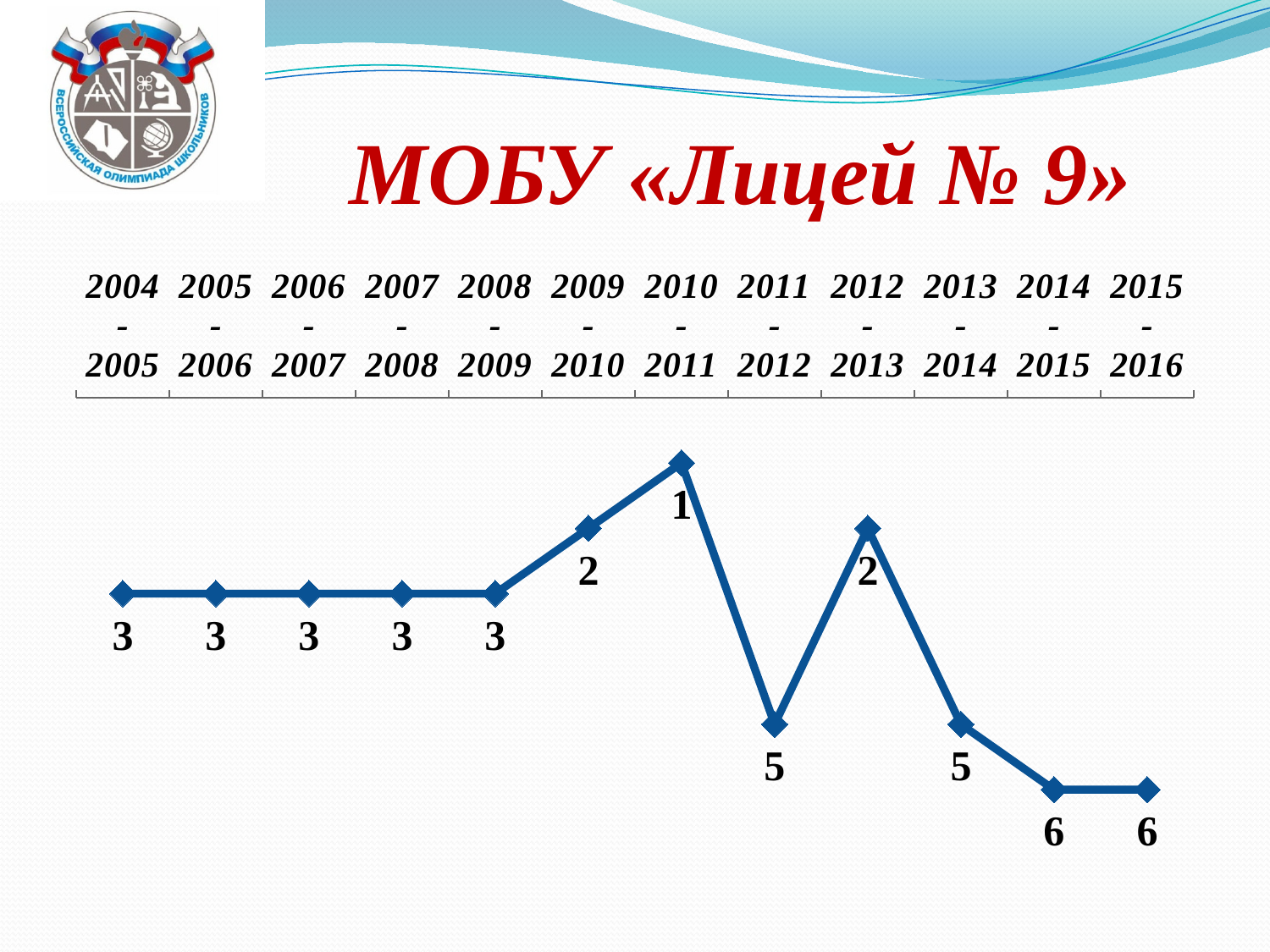
What is the title of the slide above the chart? МОБУ «Лицей № 9» What is the value for 2009-2010? 2 What kind of chart is shown on the slide? line chart Which period has the lowest value? 2010-2011 Do the values rise, fall or stay the same from 2004-2005 to 2008-2009? stay the same How many periods are plotted on the chart? 12 What is the difference between the values for 2014-2015 and 2012-2013? 4 Which is larger, the value for 2013-2014 or the value for 2012-2013? 2013-2014 What is the value for 2010-2011? 1 What is the value for 2015-2016? 6 What is the difference between the values for 2011-2012 and 2010-2011? 4 What is the value for 2011-2012? 5